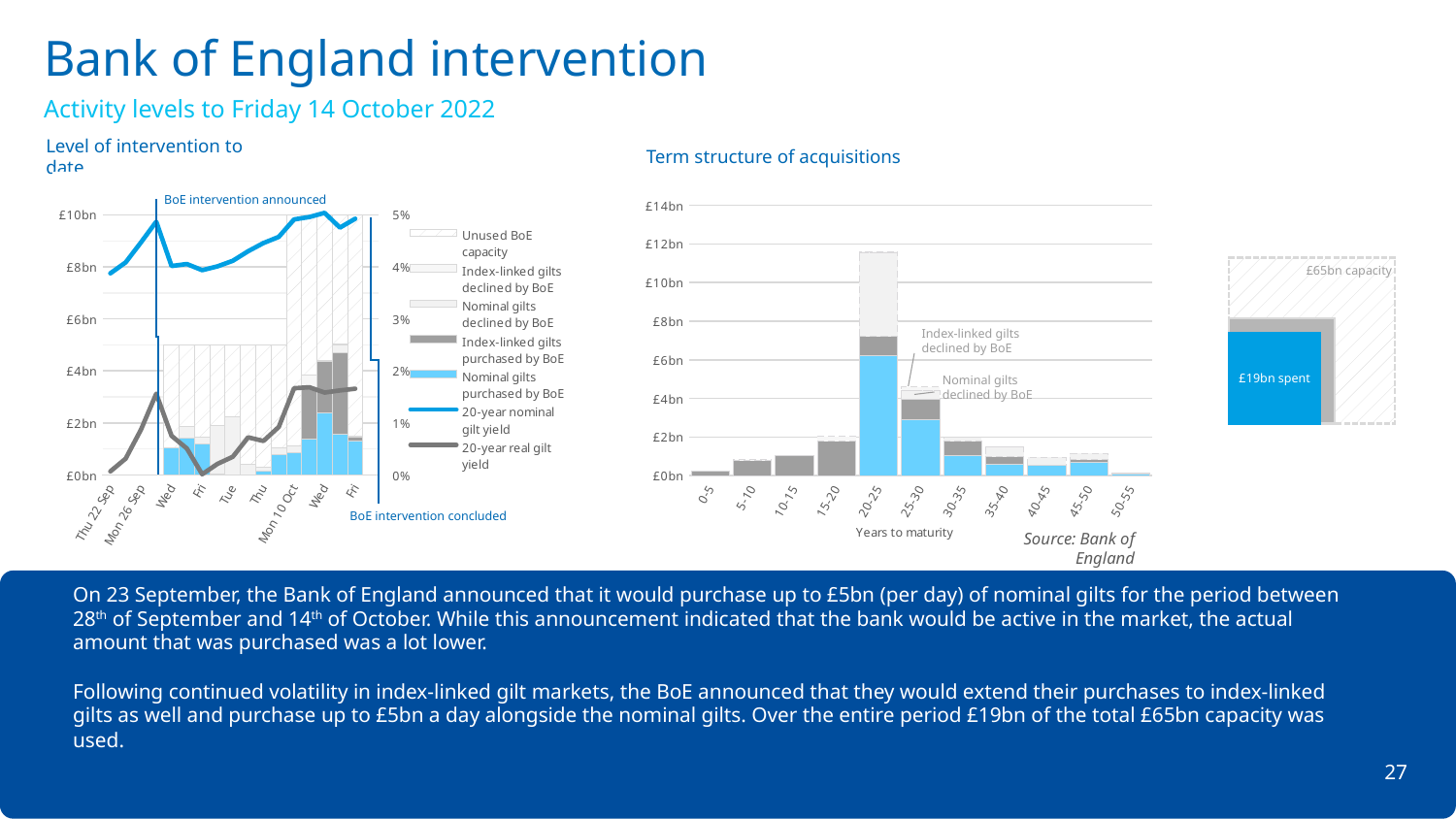
How many entries does the legend of the 'Level of intervention to date' chart list? 7 In the 'Term structure of acquisitions' chart, is the total bar for the 25-30 years bucket greater or less than £6bn? less In the 'Level of intervention to date' chart, what is the highest value labelled on the left-hand axis? £10bn In the 'Term structure of acquisitions' chart, which bar is taller: 10-15 years or 15-20 years? 15-20 In the 'Level of intervention to date' chart, what is the first date label on the x axis? Thu 22 Sep In the 'Term structure of acquisitions' chart, is the bar for the 0-5 years bucket greater or less than £2bn? less In the 'Term structure of acquisitions' chart, how many years-to-maturity categories are shown on the x axis? 11 In the 'Term structure of acquisitions' chart, which bar is taller: 20-25 years or 25-30 years? 20-25 In the 'Term structure of acquisitions' chart, is the total bar for the 20-25 years bucket greater or less than £10bn? greater What is the x-axis title of the 'Term structure of acquisitions' chart? Years to maturity In the 'Term structure of acquisitions' chart, which years-to-maturity bucket has the tallest bar? 20-25 What kind of chart is the 'Term structure of acquisitions' chart? bar chart